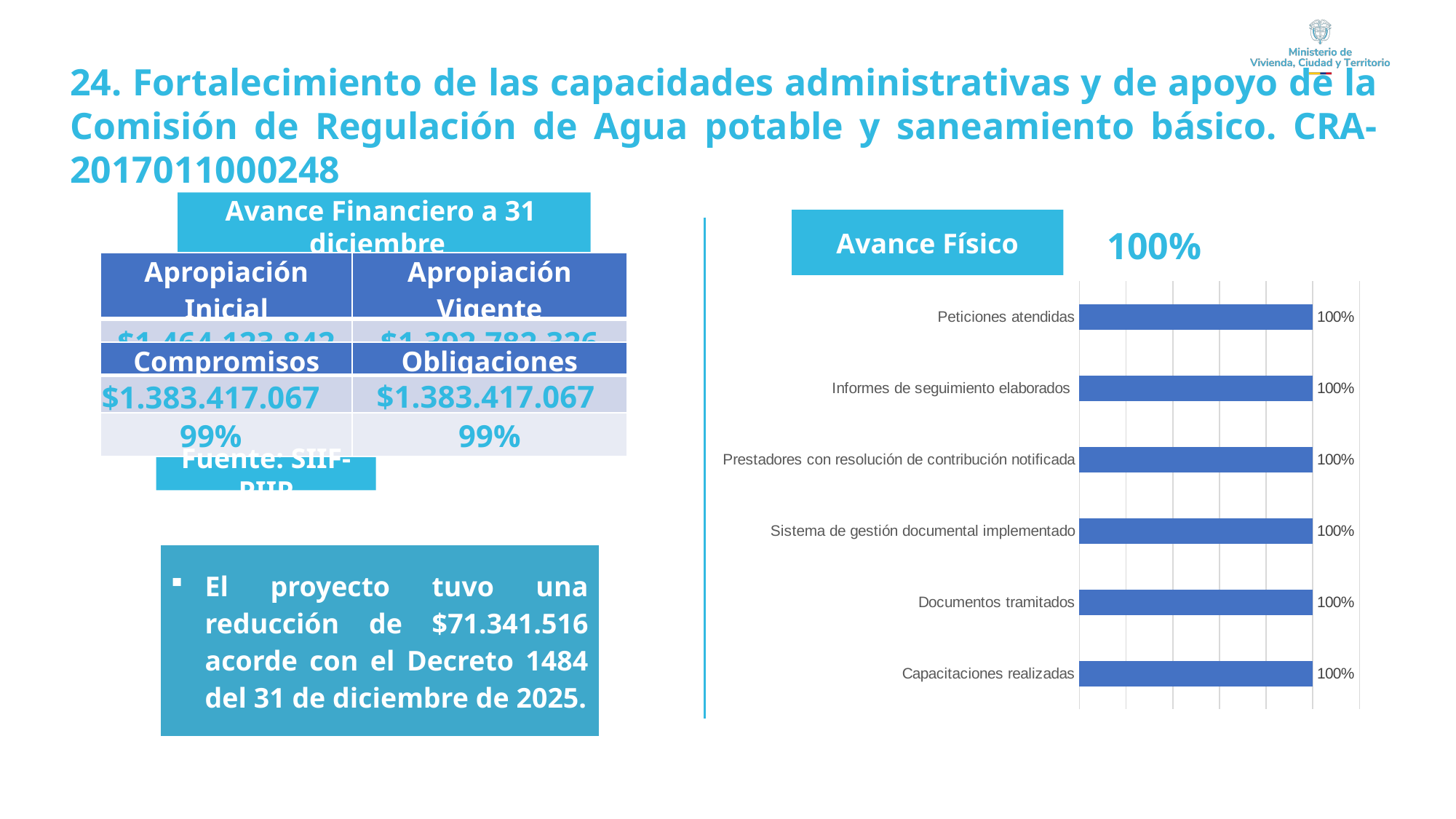
In the "Avance Físico" chart, what is the value for "Capacitaciones realizadas"? 100% In the "Avance Físico" chart, what is the value for "Prestadores con resolución de contribución notificada"? 100% Which category is listed at the top of the "Avance Físico" bar chart? Peticiones atendidas In the "Avance Físico" chart, what is the value for "Sistema de gestión documental implementado"? 100% What type of chart is shown under the heading "Avance Físico"? bar chart What overall percentage is displayed next to the "Avance Físico" heading above the chart? 100% In the "Avance Físico" chart, what is the value for "Documentos tramitados"? 100% In the "Avance Físico" chart, what is the value for "Peticiones atendidas"? 100% In the "Avance Físico" chart, what is the difference between the values for "Documentos tramitados" and "Capacitaciones realizadas"? 0% How many categories are plotted in the "Avance Físico" bar chart? 6 In the "Avance Físico" chart, what is the value for "Informes de seguimiento elaborados"? 100%